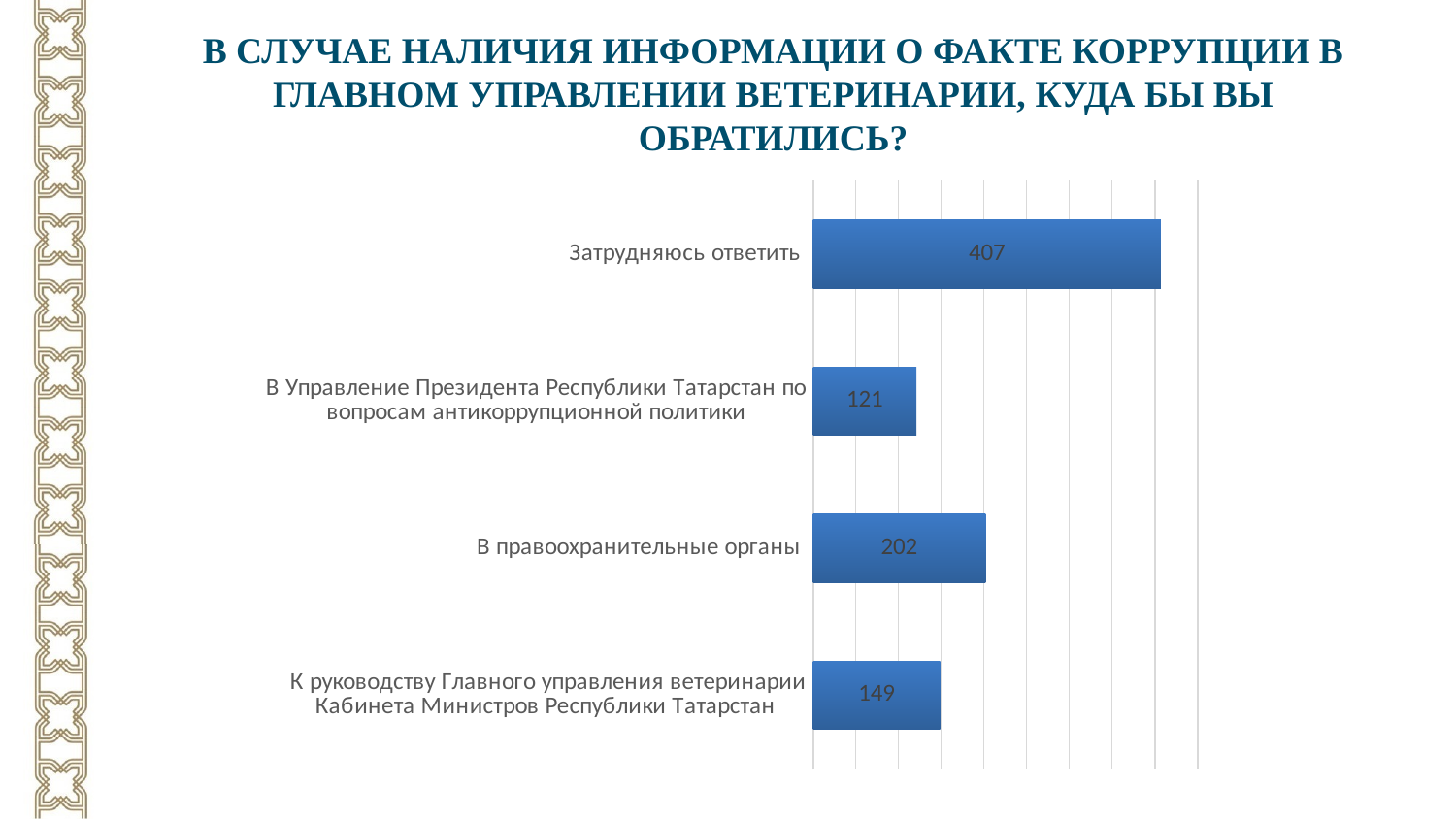
Which category has the lowest value? В Управление Президента Республики Татарстан по вопросам антикоррупционной политики What is the difference between the values for "К руководству Главного управления ветеринарии Кабинета Министров Республики Татарстан" and "В Управление Президента Республики Татарстан по вопросам антикоррупционной политики"? 28 What is the value for "В Управление Президента Республики Татарстан по вопросам антикоррупционной политики"? 121 What is the value for "В правоохранительные органы"? 202 What is the difference between the values for "Затрудняюсь ответить" and "В правоохранительные органы"? 205 Which is larger: the value for "В правоохранительные органы" or the value for "К руководству Главного управления ветеринарии Кабинета Министров Республики Татарстан"? В правоохранительные органы How many categories are shown in the chart? 4 What kind of chart is shown on the slide? Bar chart What is the value for "Затрудняюсь ответить"? 407 Which category has the highest value? Затрудняюсь ответить What is the value for "К руководству Главного управления ветеринарии Кабинета Министров Республики Татарстан"? 149 What colour are the bars in the chart? Blue